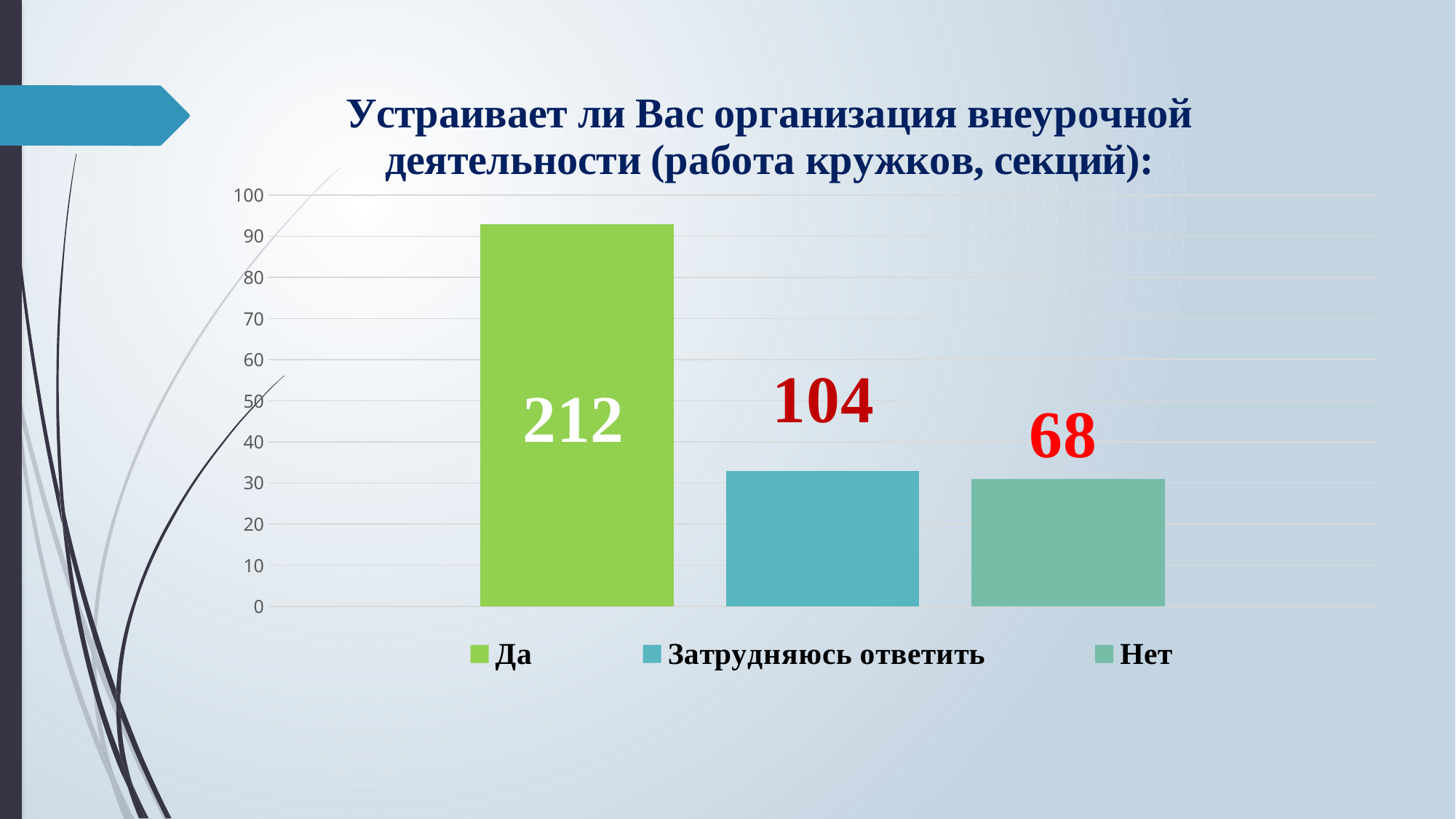
What value is shown for the "Да" bar? 212 What colour is the "Да" bar? green Which is larger, the value for "Да" or the value for "Затрудняюсь ответить"? Да Which category has the lowest value? Нет Is the top of the "Да" bar greater or less than 80 on the axis? greater Which category has the highest value? Да What value is shown for the "Затрудняюсь ответить" bar? 104 What is the difference between the values for "Затрудняюсь ответить" and "Нет"? 36 What value is shown for the "Нет" bar? 68 How many categories are shown in the chart? 3 What is the difference between the values for "Да" and "Нет"? 144 What kind of chart is shown on the slide? bar chart